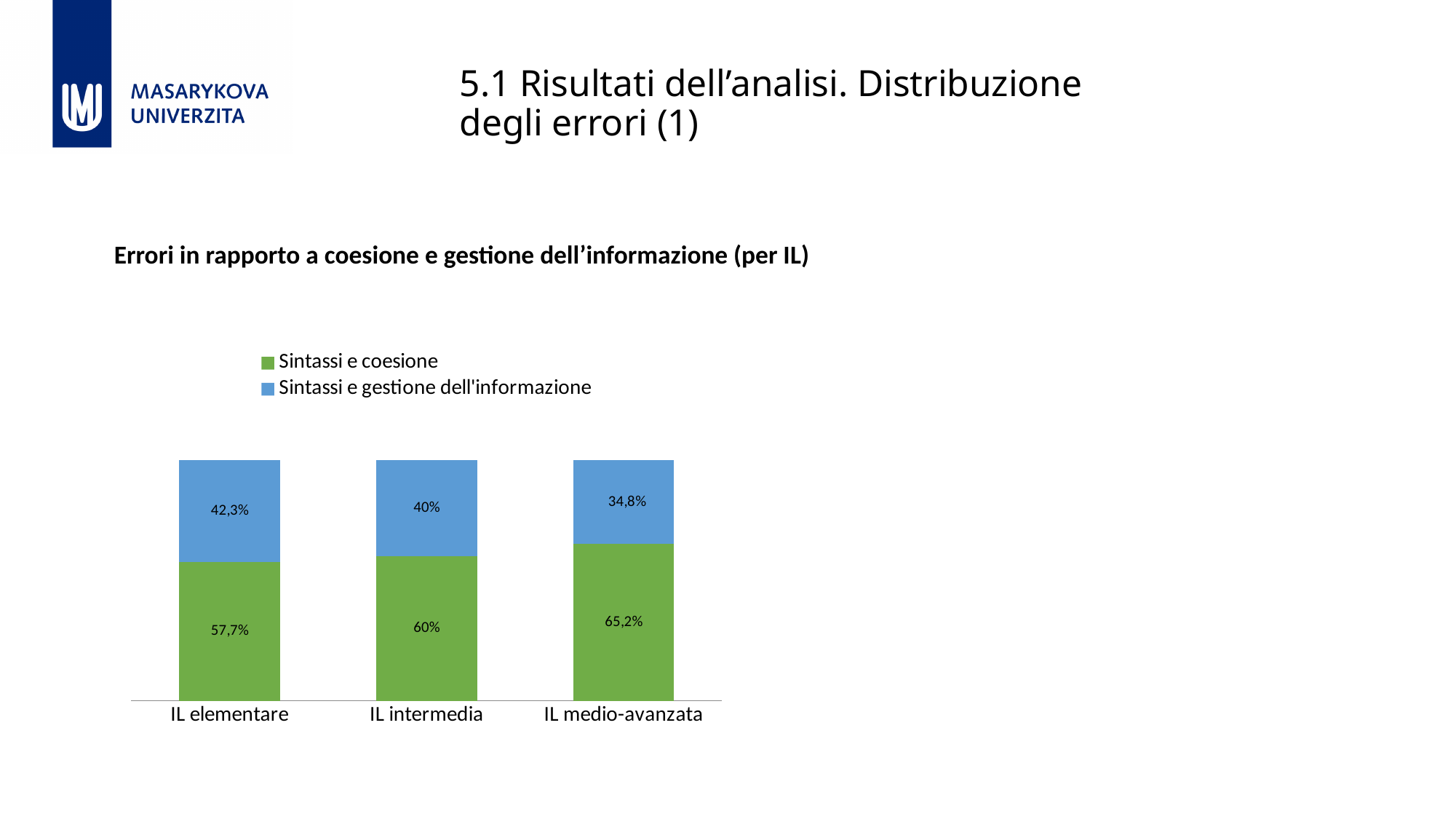
What is the value for Sintassi e gestione dell'informazione for IL intermedia? 40% Which is larger: Sintassi e coesione for IL intermedia or Sintassi e gestione dell'informazione for IL intermedia? Sintassi e coesione What is the value for Sintassi e gestione dell'informazione for IL medio-avanzata? 34,8% What is the difference between the Sintassi e coesione values for IL medio-avanzata and IL elementare? 7,5% How many categories are shown on the x axis? 3 Which category has the highest value for Sintassi e coesione? IL medio-avanzata What is the value for Sintassi e coesione for IL medio-avanzata? 65,2% Which category has the lowest value for Sintassi e gestione dell'informazione? IL medio-avanzata What kind of chart is shown on the slide? Stacked bar chart Does the value for Sintassi e gestione dell'informazione rise or fall from IL elementare to IL medio-avanzata? Fall What is the value for Sintassi e coesione for IL elementare? 57,7% How many series does the legend list? 2